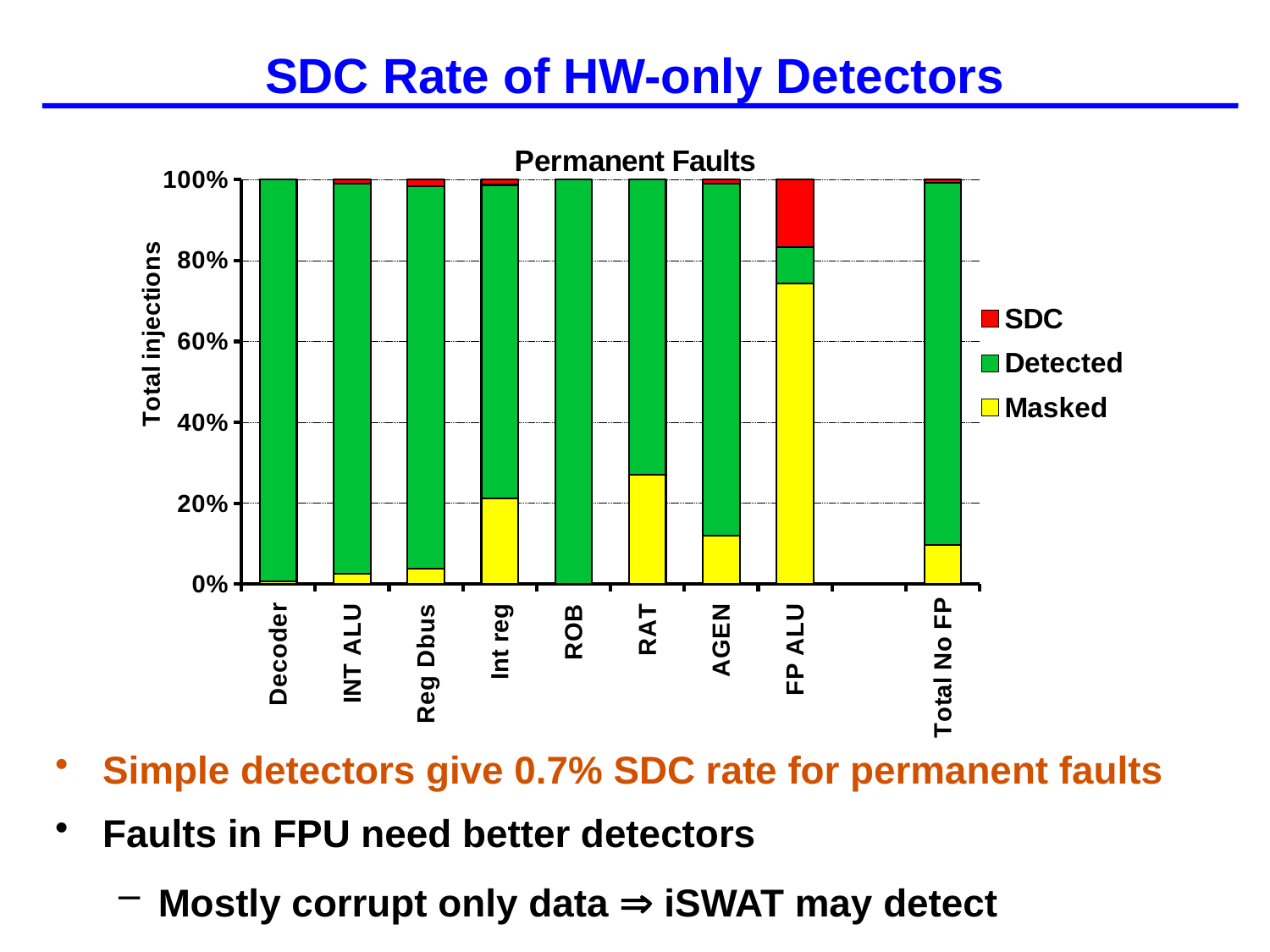
Which category has the largest Masked share? FP ALU Which category has the largest SDC share? FP ALU What kind of chart is shown on the slide? Stacked bar chart What is the label on the chart's y axis? Total injections How many series does the chart's legend list? 3 Is the Masked value for AGEN greater or less than 20%? less Is the Masked value for RAT greater or less than 20%? greater Which category has a larger Masked share, RAT or AGEN? RAT What is the title of the chart? Permanent Faults Is the Masked value for FP ALU greater or less than 60%? greater How many categories are shown along the x axis of the chart? 9 What is the total height of the stacked bar for ROB? 100%